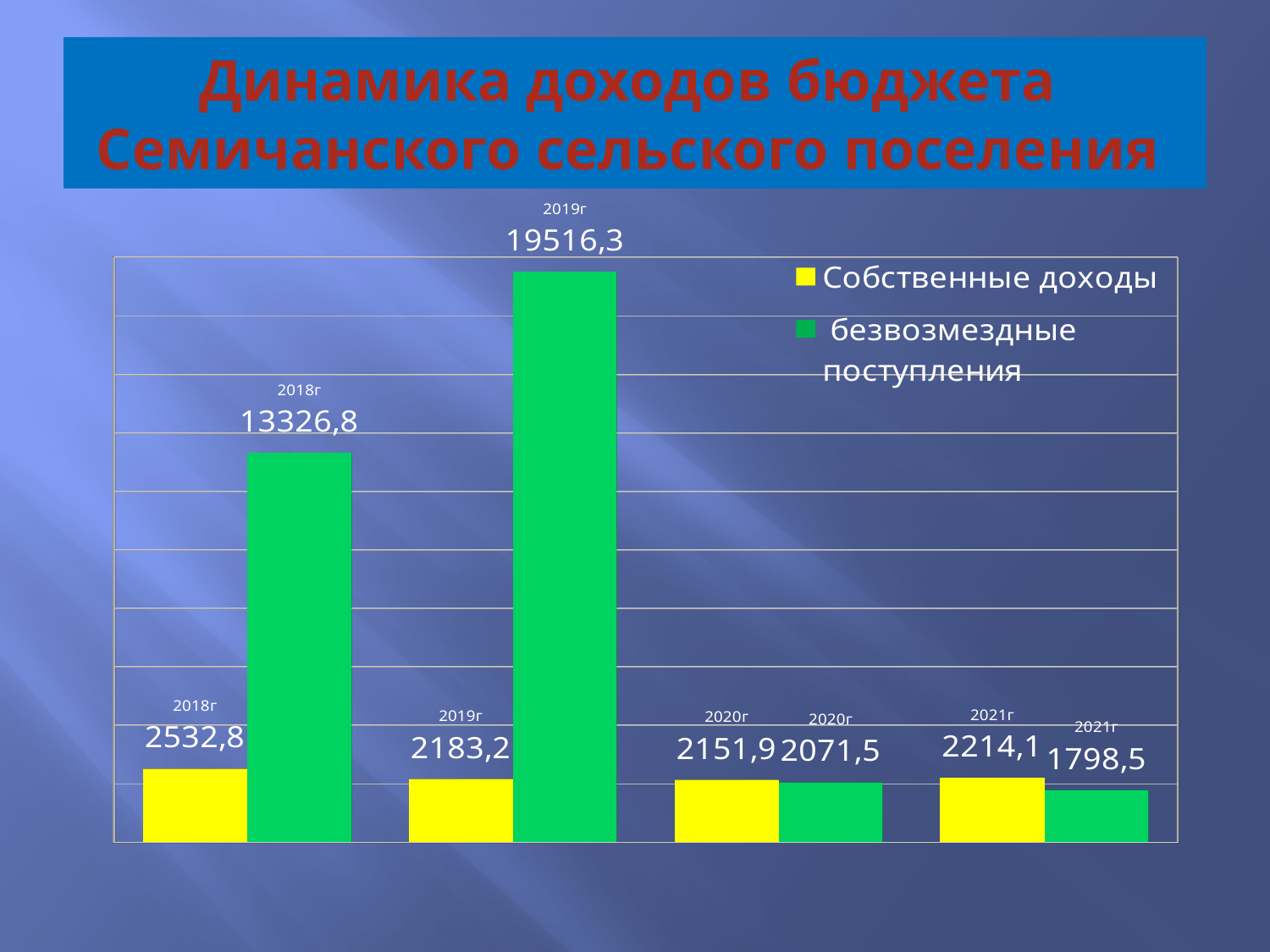
How many series does the legend list? 2 In which year is Собственные доходы highest? 2018г In which year is безвозмездные поступления lowest? 2021г What is the difference between безвозмездные поступления in 2019г and 2018г? 6189,5 What is the difference between Собственные доходы and безвозмездные поступления in 2021г? 415,6 In which year is безвозмездные поступления highest? 2019г Which is larger in 2020г: Собственные доходы or безвозмездные поступления? Собственные доходы What is the value of безвозмездные поступления for 2019г? 19516,3 What is the value of Собственные доходы for 2020г? 2151,9 What is the value of безвозмездные поступления for 2021г? 1798,5 What is the value of Собственные доходы for 2018г? 2532,8 How many years are shown on the x axis? 4